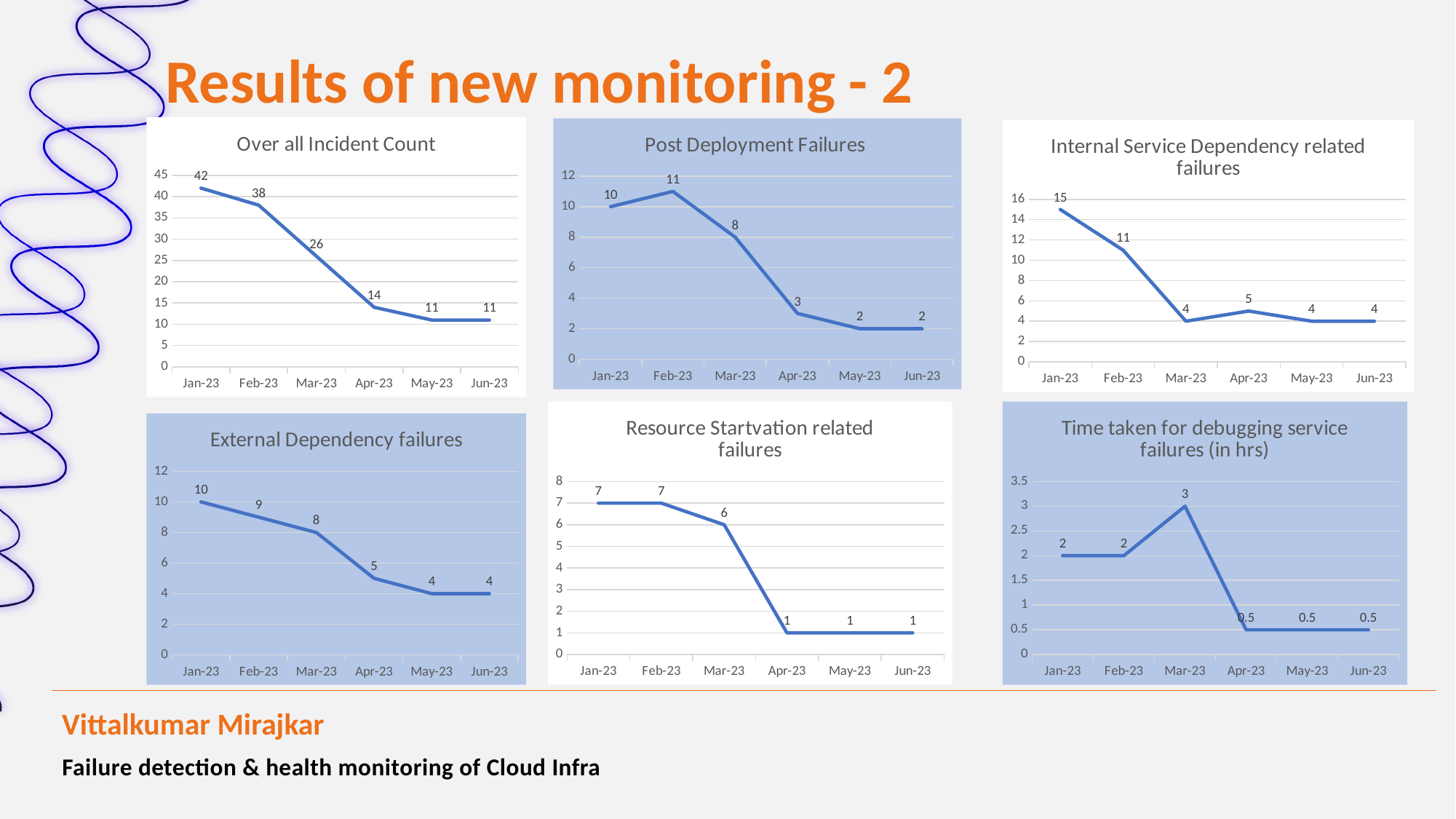
In the 'Over all Incident Count' chart, what is the difference between the Jan-23 and Jun-23 values? 31 What kind of chart is the 'Over all Incident Count' chart? line chart In the 'Resource Startvation related failures' chart, what is the value for Mar-23? 6 In the 'External Dependency failures' chart, what is the value for Feb-23? 9 In the 'Internal Service Dependency related failures' chart, which month has the highest value? Jan-23 In the 'Internal Service Dependency related failures' chart, what is the value for Apr-23? 5 In the 'External Dependency failures' chart, is the value for Mar-23 larger or smaller than the value for Apr-23? larger In the 'Time taken for debugging service failures (in hrs)' chart, which month has the highest value? Mar-23 In the 'Over all Incident Count' chart, what is the value for Jan-23? 42 In the 'Time taken for debugging service failures (in hrs)' chart, what is the value for Jun-23? 0.5 In the 'Post Deployment Failures' chart, what is the value for Mar-23? 8 In the 'Post Deployment Failures' chart, which month has the highest value? Feb-23